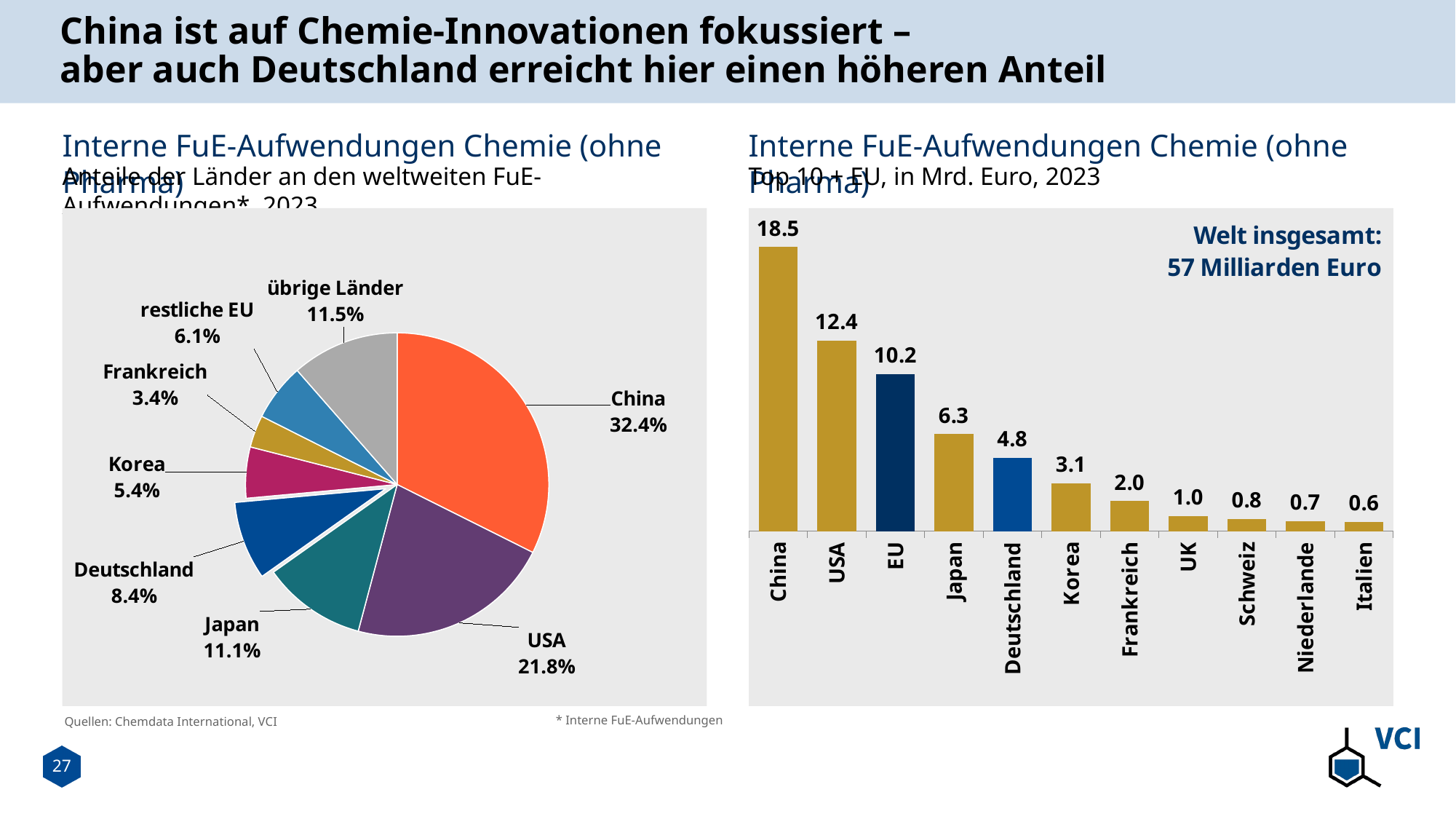
In the bar chart on the right, how many bars are shown? 11 In the bar chart on the right, what is the difference between the values for China and EU? 8.3 In the pie chart on the left, which is larger, the share of Japan or the share of übrige Länder? übrige Länder In the pie chart on the left, what share does China have? 32.4% In the pie chart on the left, which category has the smallest share? Frankreich In the pie chart on the left, how many slices are there? 8 What type of chart is shown on the right side of the slide? Bar chart In the bar chart on the right, what is the value for USA? 12.4 In the pie chart on the left, what share does Deutschland have? 8.4% In the bar chart on the right, which country has the lowest value? Italien In the bar chart on the right, what is the value for Deutschland? 4.8 In the pie chart on the left, what is the difference between the shares of China and USA? 10.6%